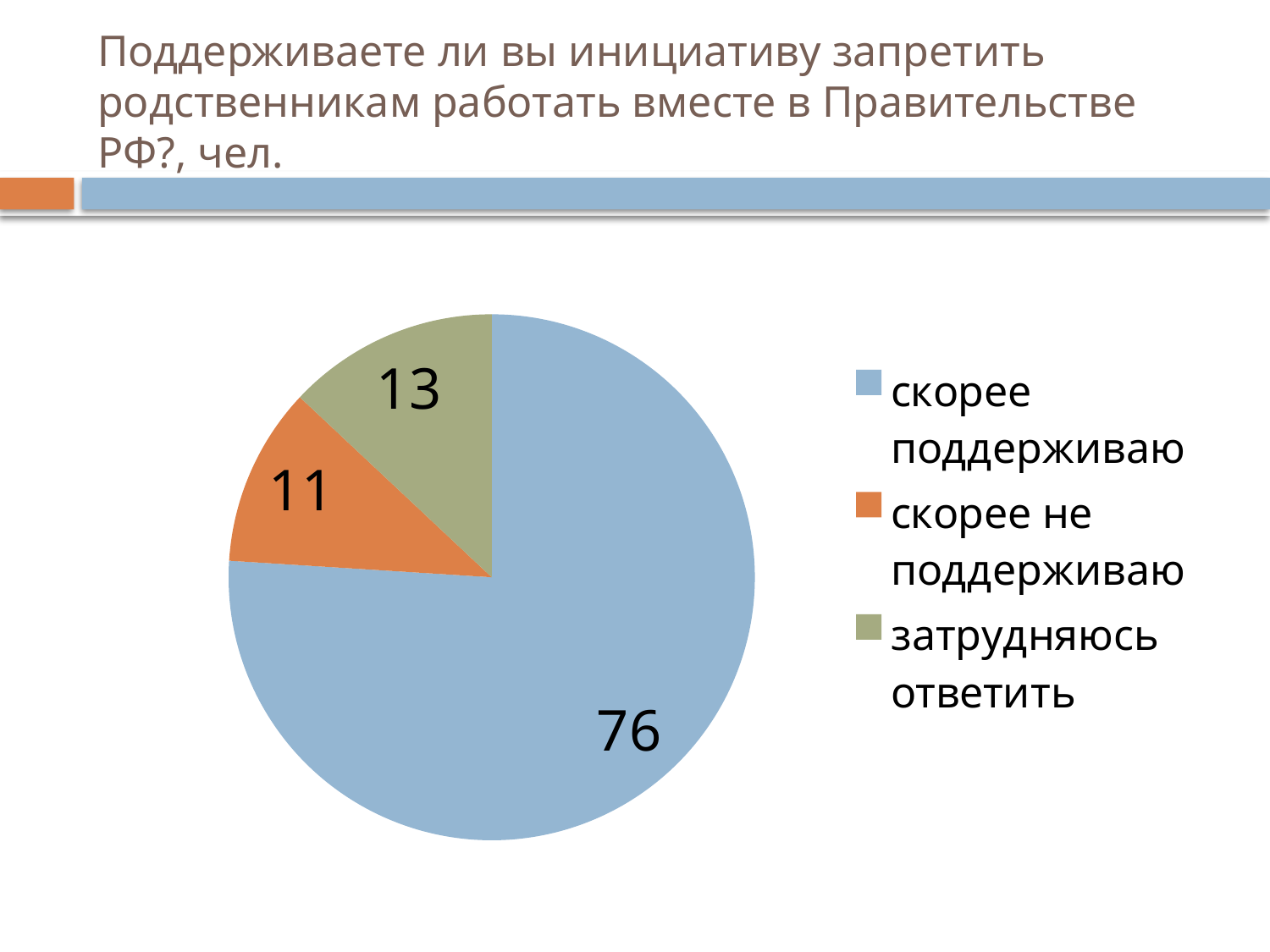
What is the total number of respondents across all slices of the pie? 100 Which answer option has the largest slice of the pie? скорее поддерживаю How many answer options (slices) does the pie chart show? 3 Which is larger: the number of people who answered "затрудняюсь ответить" or "скорее не поддерживаю"? затрудняюсь ответить What is the difference between the number of people who answered "скорее поддерживаю" and those who answered "затрудняюсь ответить"? 63 What is the difference between the number of people who answered "затрудняюсь ответить" and those who answered "скорее не поддерживаю"? 2 How many people answered "затрудняюсь ответить"? 13 How many people answered "скорее не поддерживаю"? 11 What type of chart is shown on the slide? pie chart Which answer option has the smallest slice of the pie? скорее не поддерживаю How many people answered "скорее поддерживаю"? 76 What colour is the slice for "скорее не поддерживаю"? orange